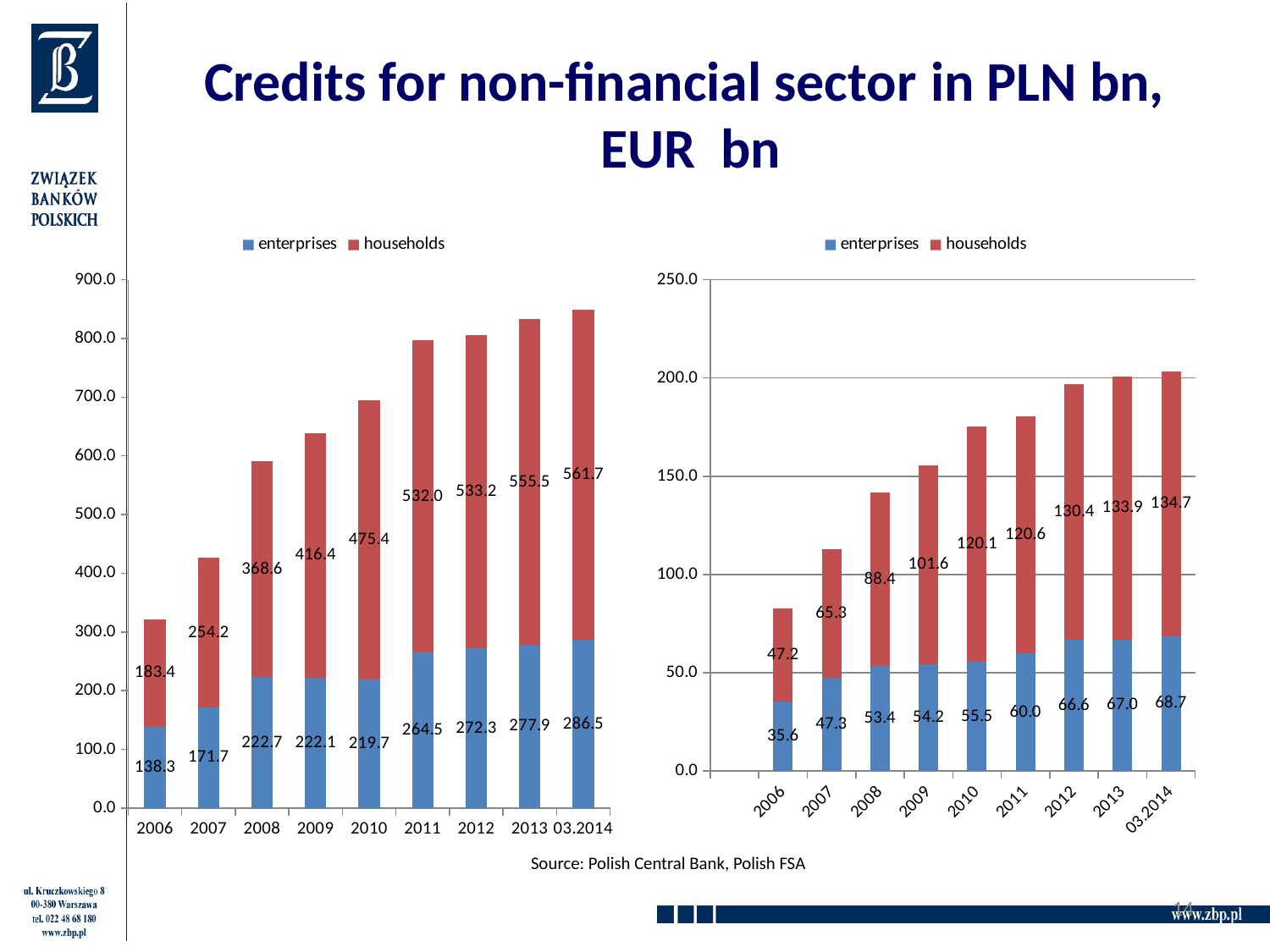
On the left chart, what is the total of the stacked bar for 2006? 321.7 On the right chart, what is the total of the stacked bar for 03.2014? 203.4 On the left chart, which is larger: households in 2008 or households in 2009? households in 2009 On the left chart, which year has the lowest value for enterprises? 2006 On the left chart, what is the difference between the households values for 2013 and 2012? 22.3 On the right chart, what is the value for enterprises in 2009? 54.2 On the right chart, which period has the highest value for households? 03.2014 On the left chart, what is the value for households in 2010? 475.4 How many series does the legend of the left chart list? 2 On the right chart, what is the difference between the enterprises values for 2012 and 2011? 6.6 What kind of chart is the left chart? stacked bar chart How many periods are shown on the x axis of the right chart? 9